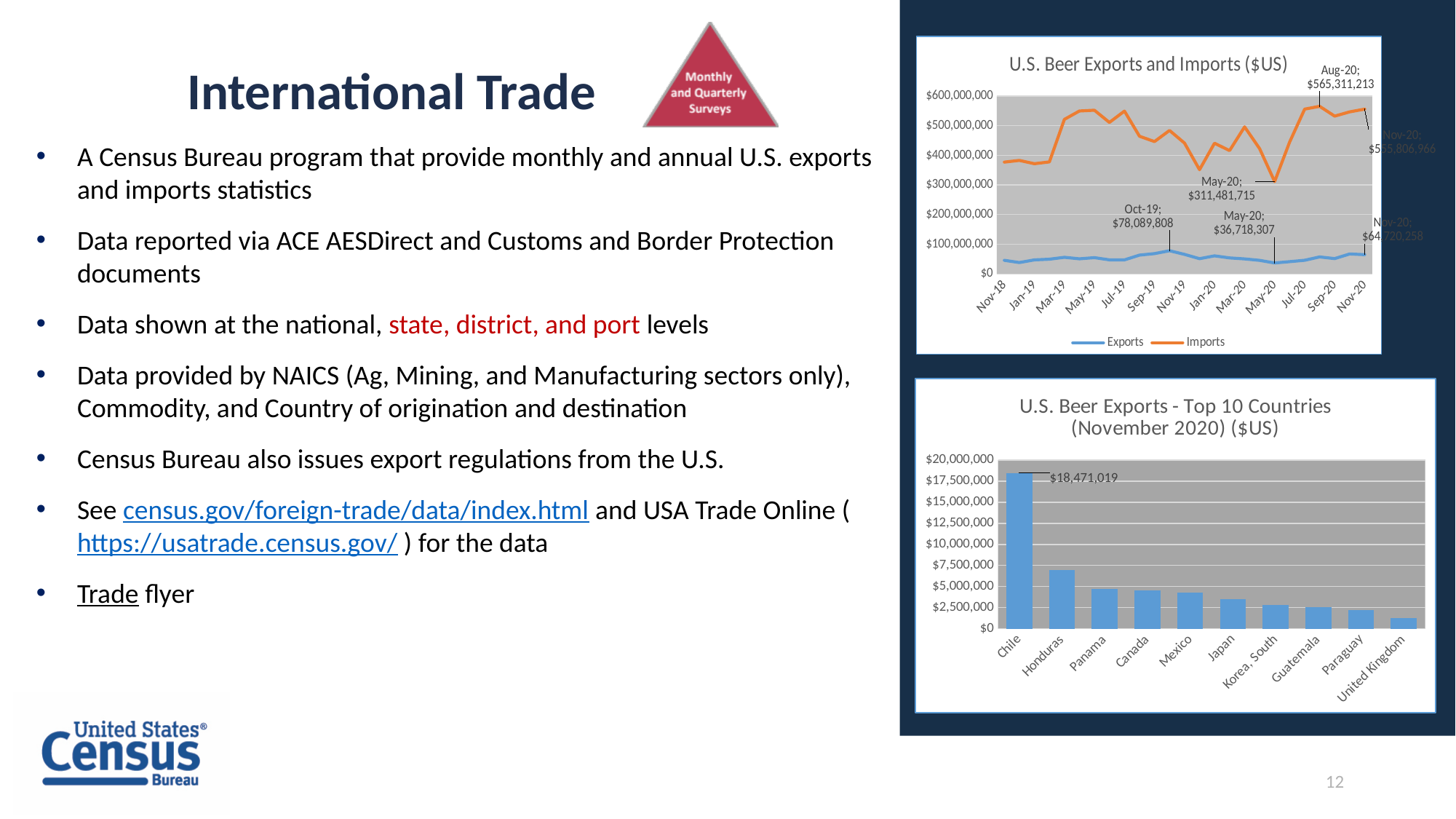
What kind of chart is the 'U.S. Beer Exports and Imports ($US)' chart? line chart In the 'U.S. Beer Exports and Imports ($US)' chart, what is the value of Exports for May-20? $36,718,307 In the 'U.S. Beer Exports - Top 10 Countries (November 2020) ($US)' chart, which country has the lowest value? United Kingdom In the 'U.S. Beer Exports and Imports ($US)' chart, what is the value of Exports for Oct-19? $78,089,808 In the 'U.S. Beer Exports and Imports ($US)' chart, what is the difference between Imports in Aug-20 and Imports in May-20? $253,829,498 What kind of chart is the 'U.S. Beer Exports - Top 10 Countries (November 2020) ($US)' chart? bar chart In the 'U.S. Beer Exports and Imports ($US)' chart, what is the value of Imports for May-20? $311,481,715 In the 'U.S. Beer Exports - Top 10 Countries (November 2020) ($US)' chart, what is the value for Chile? $18,471,019 In the 'U.S. Beer Exports and Imports ($US)' chart, how many series does the legend list? 2 In the 'U.S. Beer Exports - Top 10 Countries (November 2020) ($US)' chart, is the value for Honduras greater or less than $7,500,000? less In the 'U.S. Beer Exports and Imports ($US)' chart, what is the value of Imports for Aug-20? $565,311,213 In the 'U.S. Beer Exports and Imports ($US)' chart, which series has the larger value in May-20, Exports or Imports? Imports